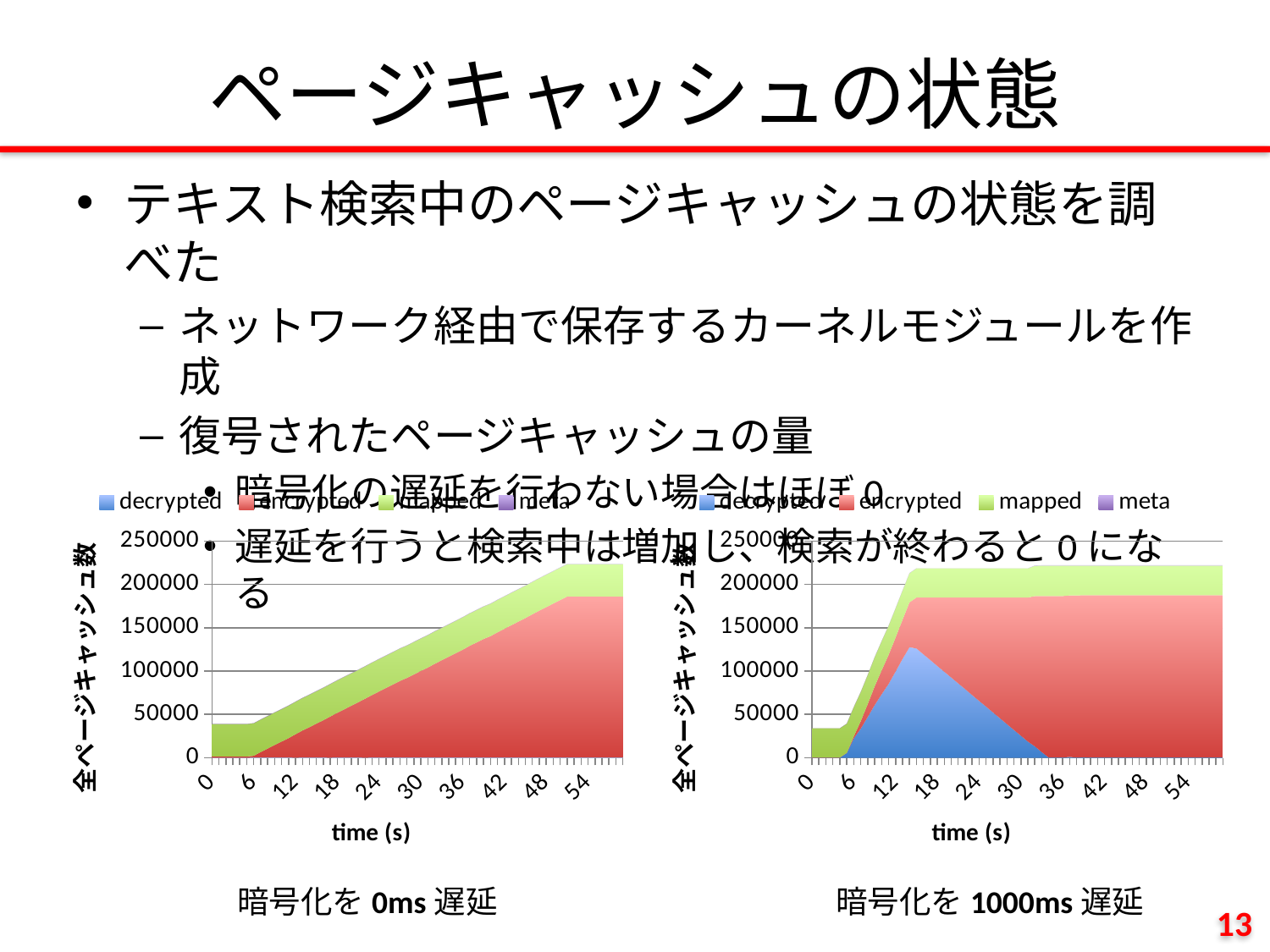
In the right chart (暗号化を 1000ms 遅延), does the decrypted series rise or fall between time 18 and time 36? fall In the left chart (暗号化を 0ms 遅延), is the total page cache count at time 0 greater or less than 50000? less In the right chart (暗号化を 1000ms 遅延), is the peak value of the decrypted series greater or less than 100000? greater In the right chart (暗号化を 1000ms 遅延), what is the highest value shown on the y axis? 250000 In the left chart (暗号化を 0ms 遅延), does the total page cache count rise or fall between time 6 and time 48? rise In the left chart (暗号化を 0ms 遅延), what is the label of the x axis? time (s) In the left chart (暗号化を 0ms 遅延), is the total page cache count at time 54 greater or less than 200000? greater What kind of chart is the left chart (暗号化を 0ms 遅延)? area chart How many series does the legend of the right chart (暗号化を 1000ms 遅延) list? 4 How many labeled tick marks are on the x axis of the left chart (暗号化を 0ms 遅延)? 10